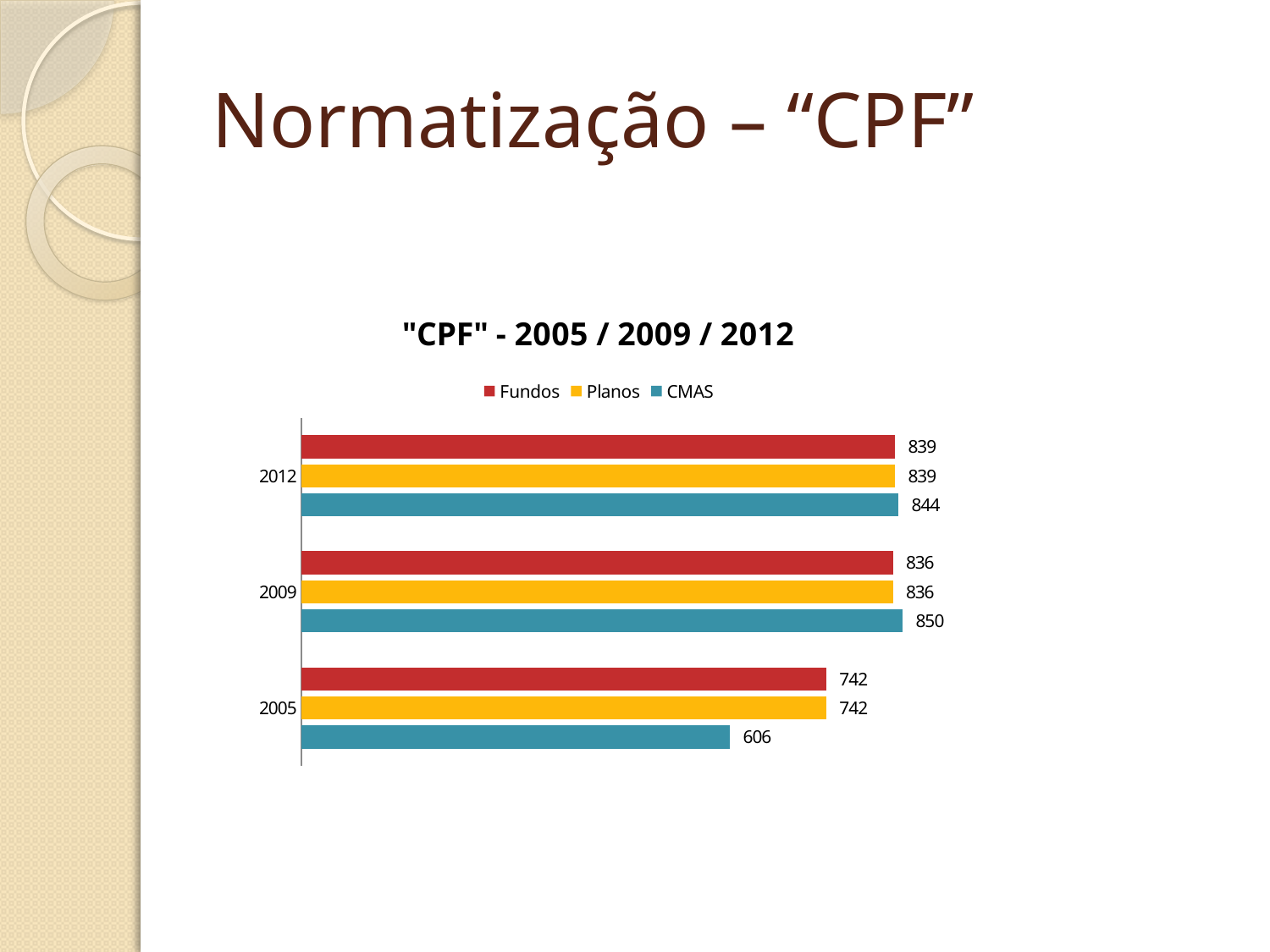
Which year has the highest value for CMAS? 2009 How many series does the legend list? 3 Does the value for CMAS rise or fall from 2005 to 2009? Rise What is the value for CMAS in 2005? 606 What is the title of the chart? "CPF" - 2005 / 2009 / 2012 Which is larger in 2005, the value for Planos or the value for CMAS? Planos How many years are shown on the chart? 3 What kind of chart is shown on the slide? Bar chart Which year has the lowest value for Fundos? 2005 What is the value for Planos in 2009? 836 What is the value for Fundos in 2012? 839 What is the difference between the CMAS value in 2009 and the CMAS value in 2005? 244